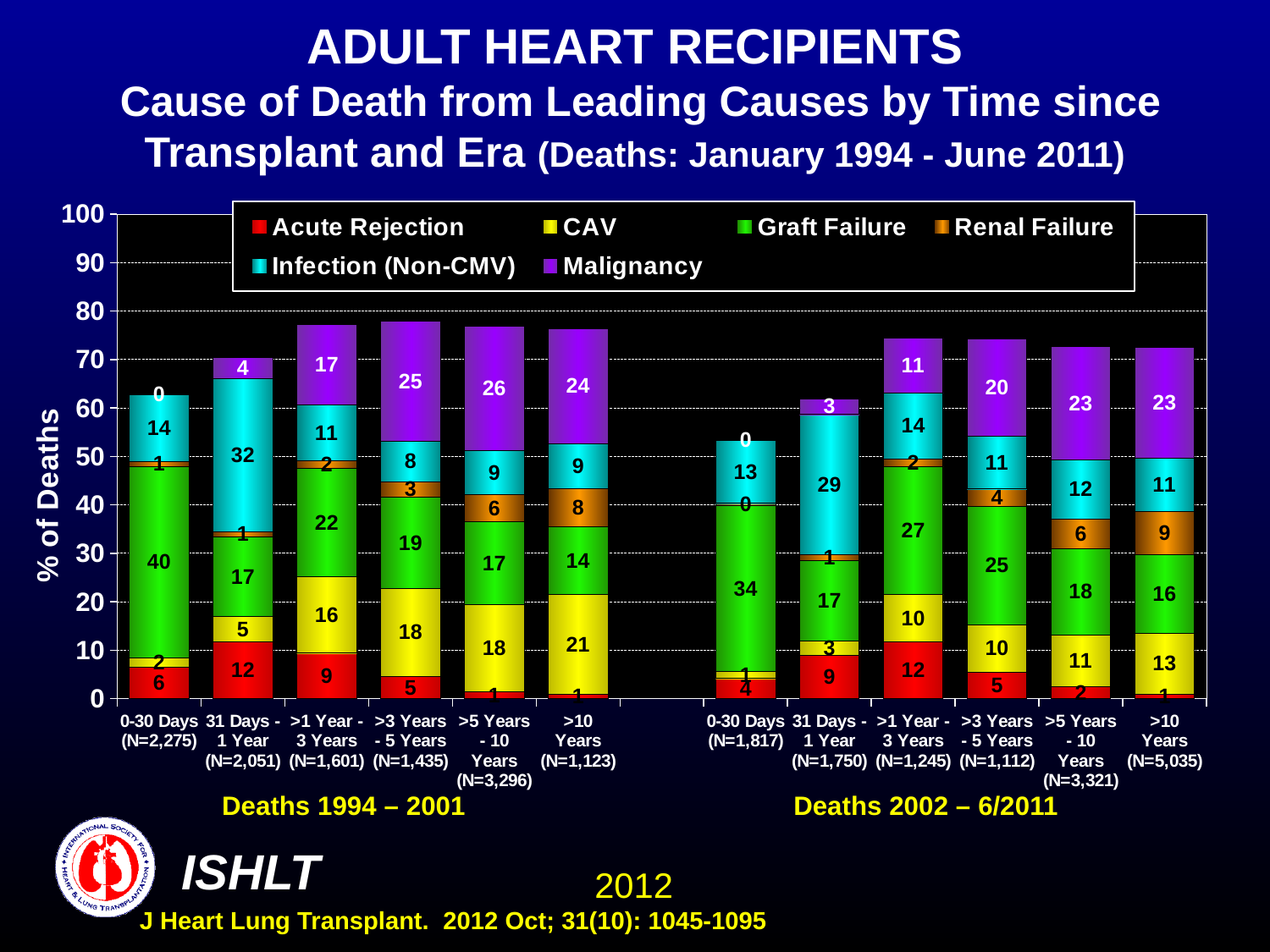
In the Deaths 2002 – 6/2011 group, does the Malignancy value rise or fall from 0-30 Days to >10 Years? Rise What is the Infection (Non-CMV) value for the 31 Days - 1 Year bar in the Deaths 2002 – 6/2011 group? 29 For the >10 Years bars, which era has the larger CAV value, Deaths 1994 – 2001 or Deaths 2002 – 6/2011? Deaths 1994 – 2001 What is the Graft Failure value for the 0-30 Days bar in the Deaths 1994 – 2001 group? 40 What is the Renal Failure value for the >10 Years bar in the Deaths 2002 – 6/2011 group? 9 In the Deaths 1994 – 2001 group, which time period has the highest Graft Failure value? 0-30 Days How many series does the legend list? 6 What kind of chart is shown on the slide? Stacked bar chart What is the Malignancy value for the >5 Years - 10 Years bar in the Deaths 1994 – 2001 group? 26 What is the label on the y axis? % of Deaths How many bars are plotted in total across both era groups? 12 What is the difference between the Malignancy value for >3 Years - 5 Years in the Deaths 1994 – 2001 group and the same period in the Deaths 2002 – 6/2011 group? 5